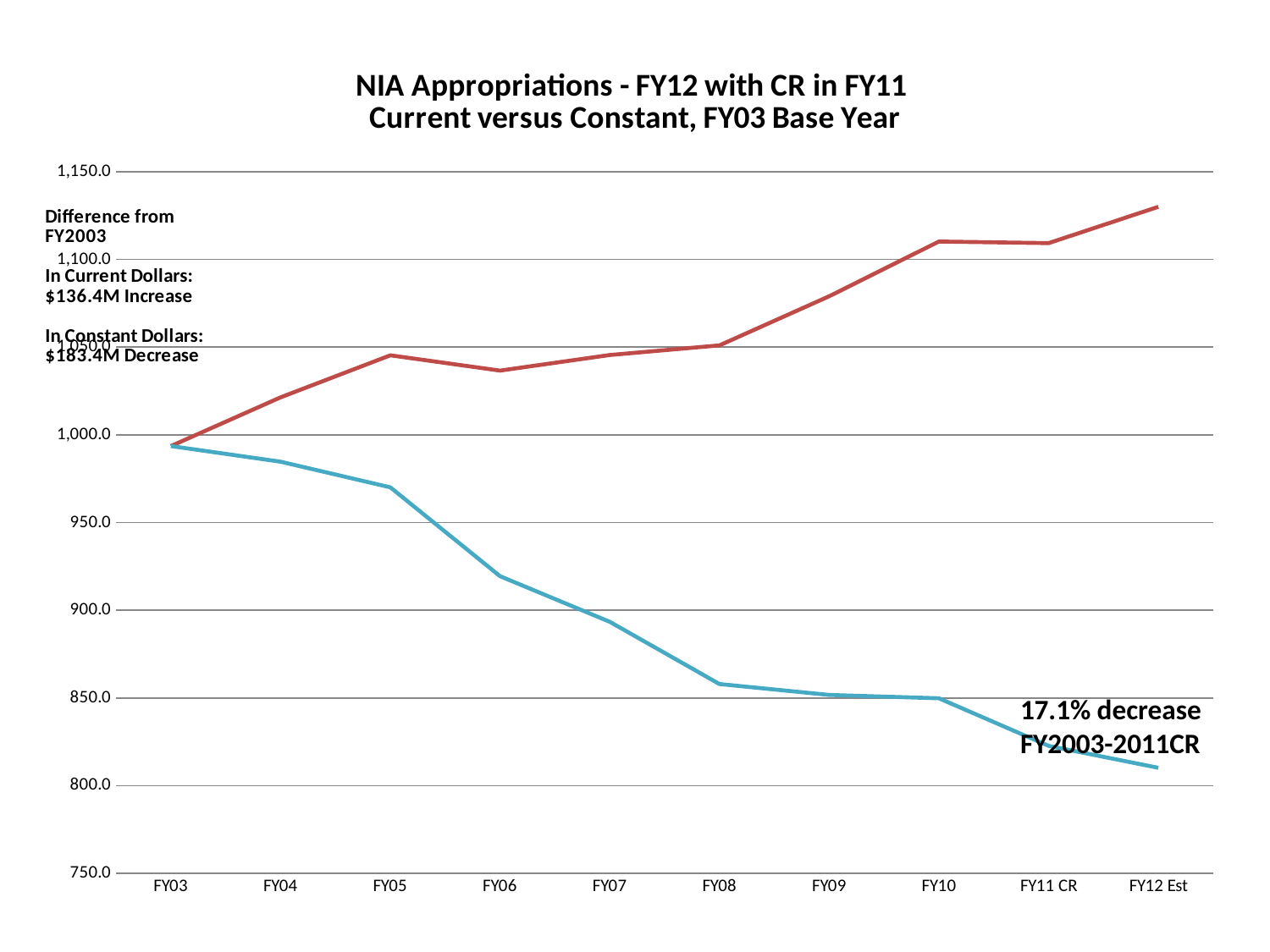
Is the value of the blue line at FY12 Est greater or less than 850? less How many fiscal-year categories are shown on the x axis? 10 What kind of chart is shown on the slide? Line chart Does the blue line rise or fall from FY03 to FY12 Est? Falls How many lines are plotted on the chart? 2 Does the red line rise or fall overall from FY03 to FY12 Est? Rises At which fiscal year is the blue line at its lowest? FY12 Est Is the value of the blue line at FY06 greater or less than 900? greater Is the value of the red line at FY12 Est greater or less than 1,100? greater At FY12 Est, which line is higher, the red line or the blue line? Red line At which fiscal year is the red line at its highest? FY12 Est What is the title of the chart? NIA Appropriations - FY12 with CR in FY11 Current versus Constant, FY03 Base Year